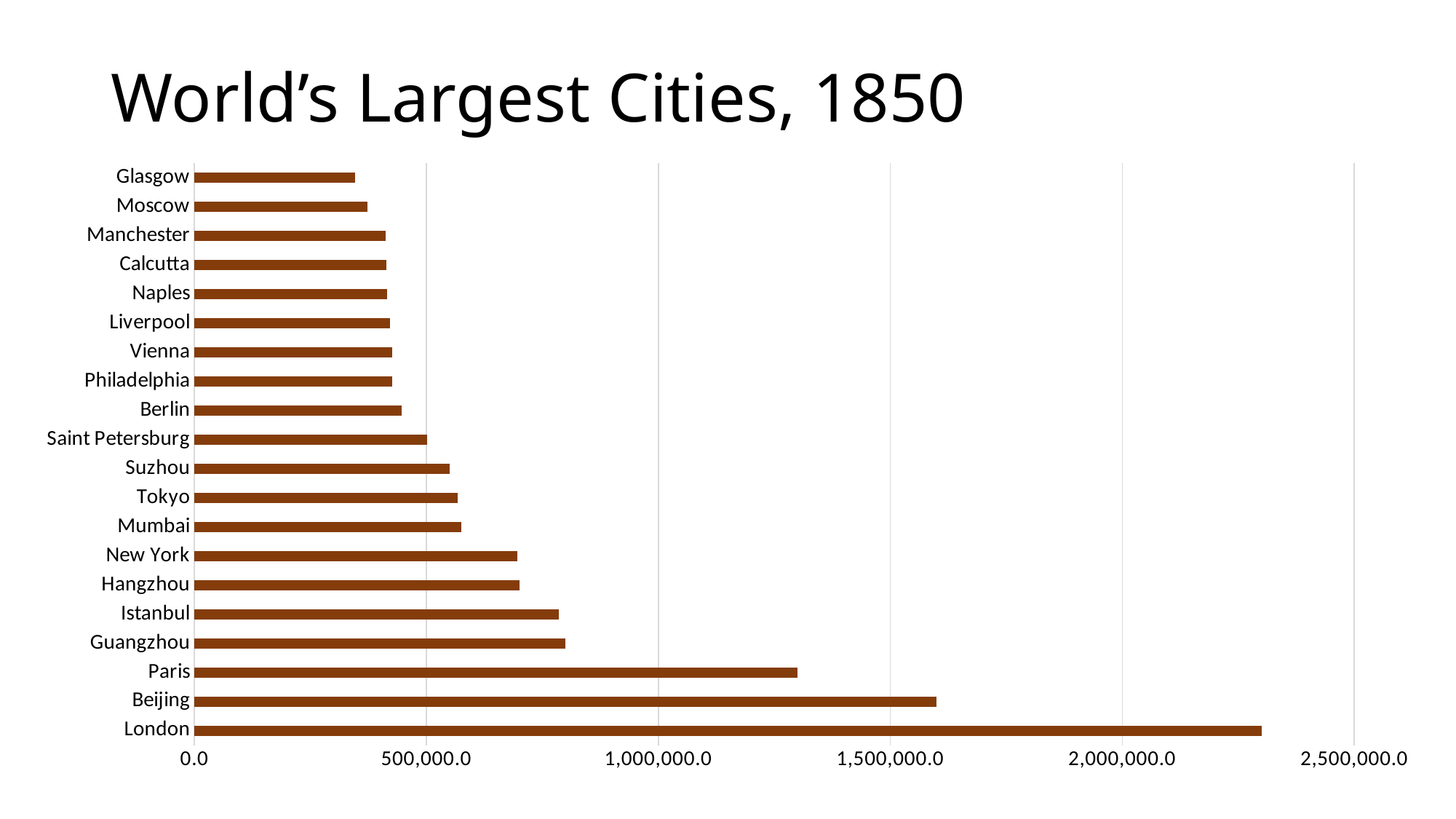
Is the value for Glasgow greater or less than 500,000? less What is the title of the chart? World's Largest Cities, 1850 What kind of chart is shown on the slide? bar chart Which city has the largest value in the chart? London Which has the larger value, Paris or Guangzhou? Paris Which city has the smallest value in the chart? Glasgow Is the value for Guangzhou greater or less than 1,000,000? less Is the value for London greater or less than 2,000,000? greater Which has the larger value, London or Beijing? London How many cities are plotted in the chart? 20